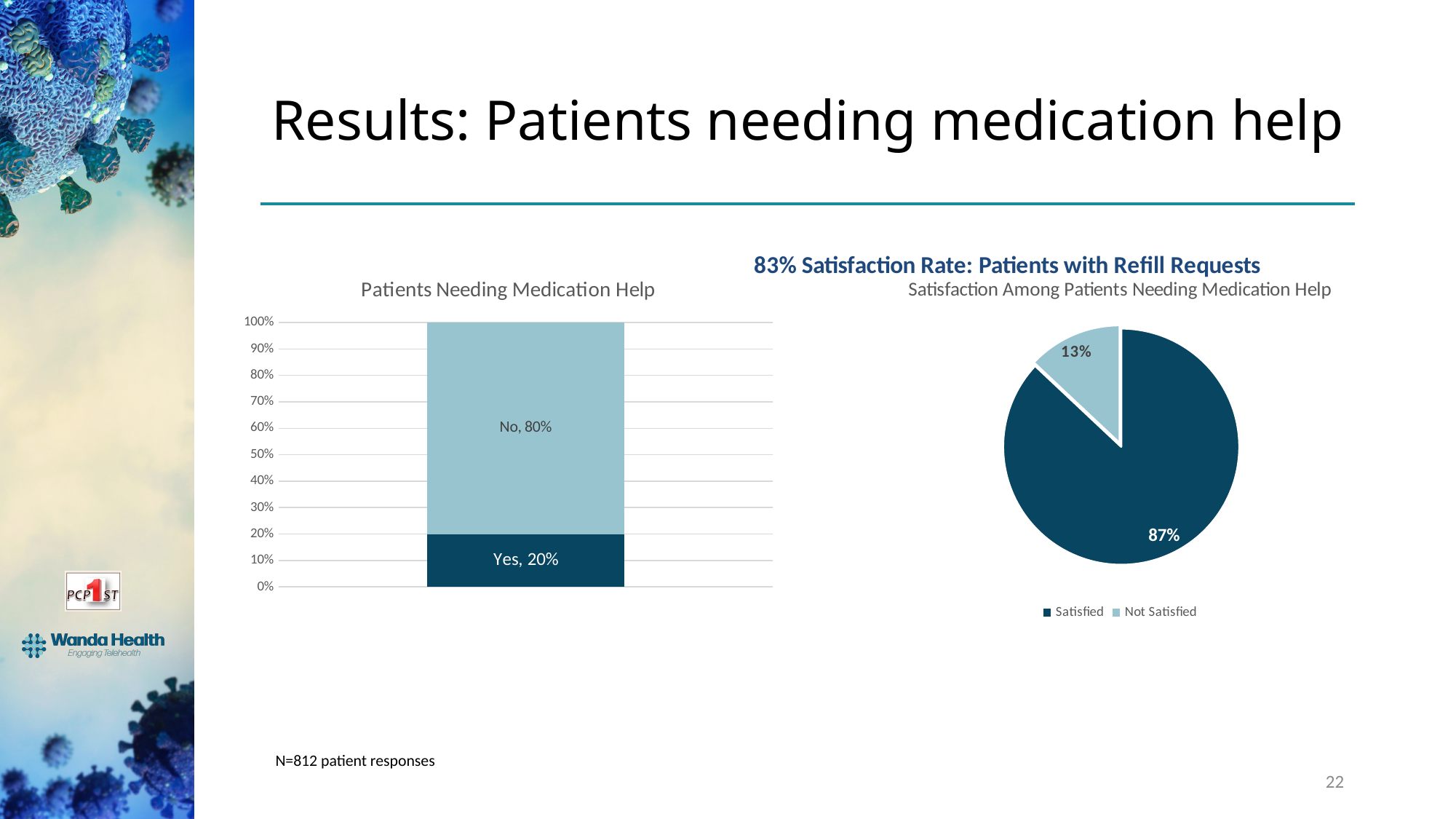
In the 'Satisfaction Among Patients Needing Medication Help' chart, what is the difference between the Satisfied and Not Satisfied shares? 74% In the 'Satisfaction Among Patients Needing Medication Help' chart, what share of patients were Not Satisfied? 13% In the 'Satisfaction Among Patients Needing Medication Help' chart, what share of patients were Satisfied? 87% In the 'Patients Needing Medication Help' chart, what percentage of patients answered No? 80% In the 'Patients Needing Medication Help' chart, which segment is larger, Yes or No? No In the 'Patients Needing Medication Help' chart, what percentage of patients answered Yes? 20% What kind of chart is 'Satisfaction Among Patients Needing Medication Help'? Pie chart In the 'Patients Needing Medication Help' chart, what is the total of the stacked bar? 100% In the 'Patients Needing Medication Help' chart, what is the difference between the No and Yes percentages? 60% In the 'Satisfaction Among Patients Needing Medication Help' chart, which slice is the smallest? Not Satisfied What kind of chart is 'Patients Needing Medication Help'? Stacked bar chart How many entries does the legend of the 'Satisfaction Among Patients Needing Medication Help' chart list? 2